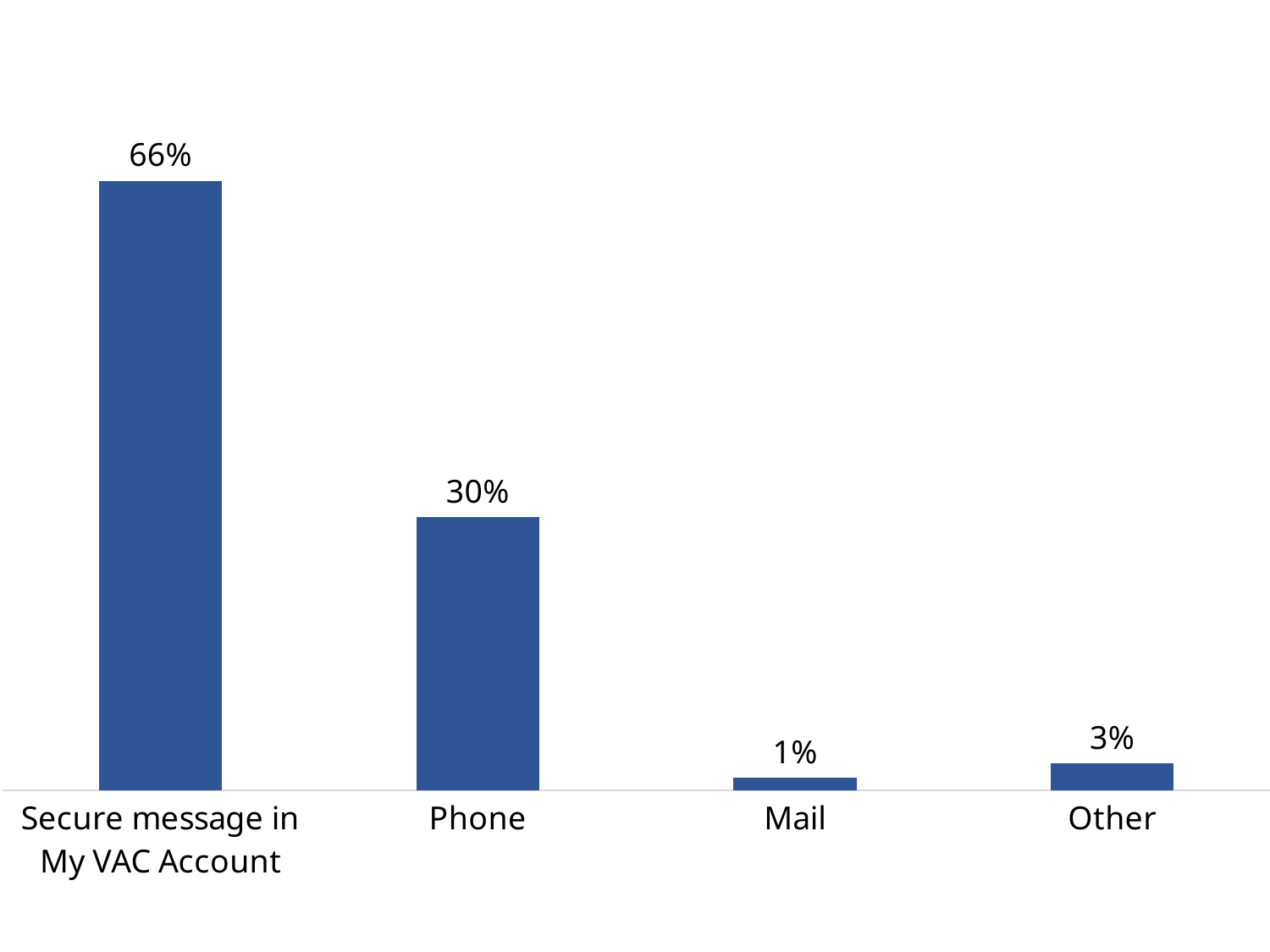
Which category has the highest value? Secure message in My VAC Account What colour are the bars in the chart? Blue Which category has the lowest value? Mail What is the difference between the values for Other and Mail? 2% What kind of chart is this? Bar chart What is the value for Phone? 30% What is the value for Other? 3% How many categories are shown in the chart? 4 What is the value for Mail? 1% What is the difference between the values for Secure message in My VAC Account and Phone? 36% What is the value for Secure message in My VAC Account? 66% Which is larger, the value for Phone or the value for Other? Phone